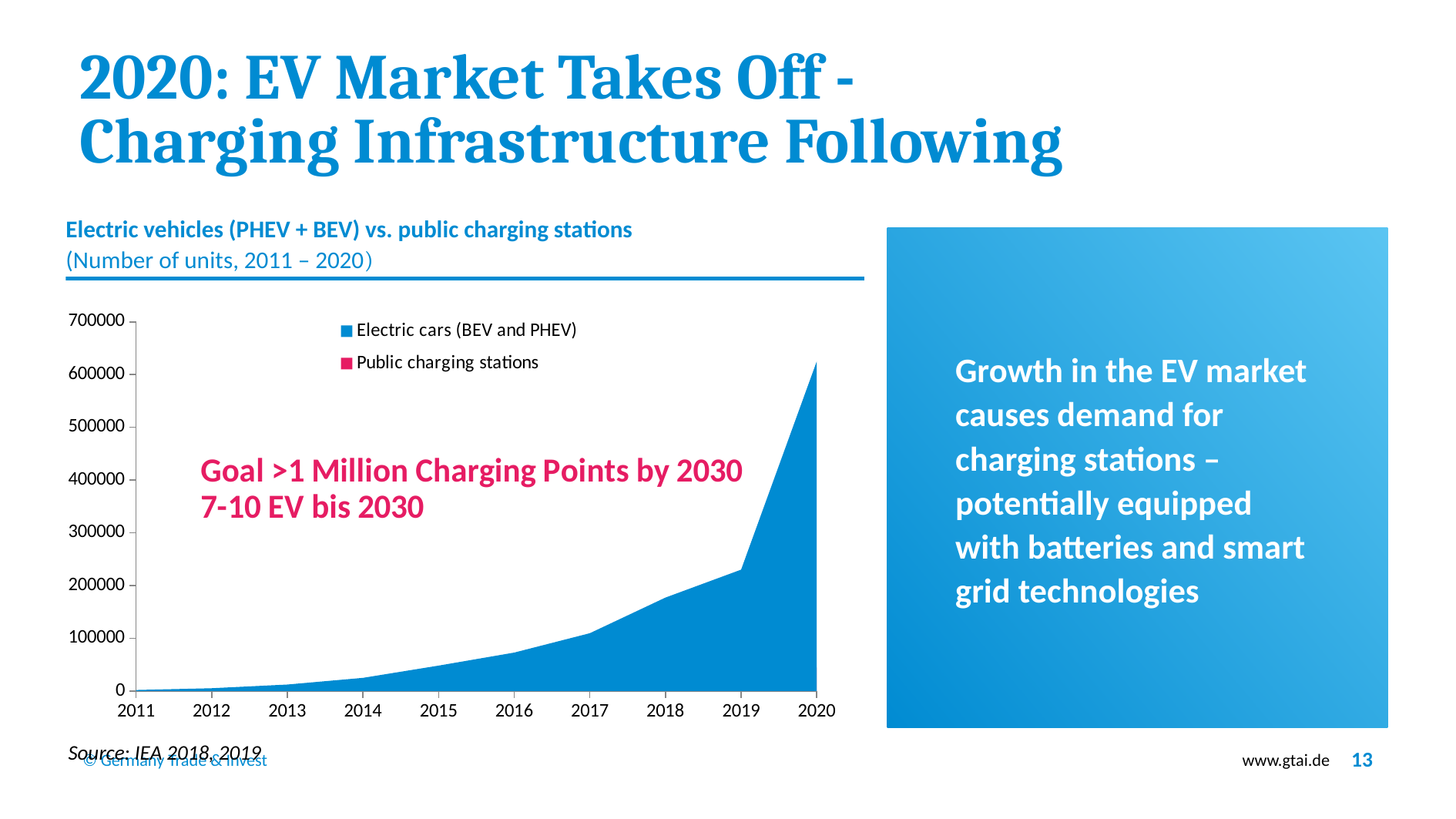
How many years are shown on the x axis? 10 Which year has the highest value for Electric cars (BEV and PHEV)? 2020 How many series does the legend list? 2 Is the value for Electric cars (BEV and PHEV) in 2020 greater or less than 500000? greater What is the title of the chart? Electric vehicles (PHEV + BEV) vs. public charging stations Is the value for Electric cars (BEV and PHEV) in 2016 greater or less than 100000? less Which year has the larger value for Electric cars (BEV and PHEV), 2019 or 2020? 2020 Which year has the lowest value for Electric cars (BEV and PHEV)? 2011 What kind of chart is shown on the slide? Area chart Do the values for Electric cars (BEV and PHEV) rise or fall from 2011 to 2020? Rise Which colour represents Public charging stations in the legend? Red Is the value for Electric cars (BEV and PHEV) in 2019 greater or less than 300000? less